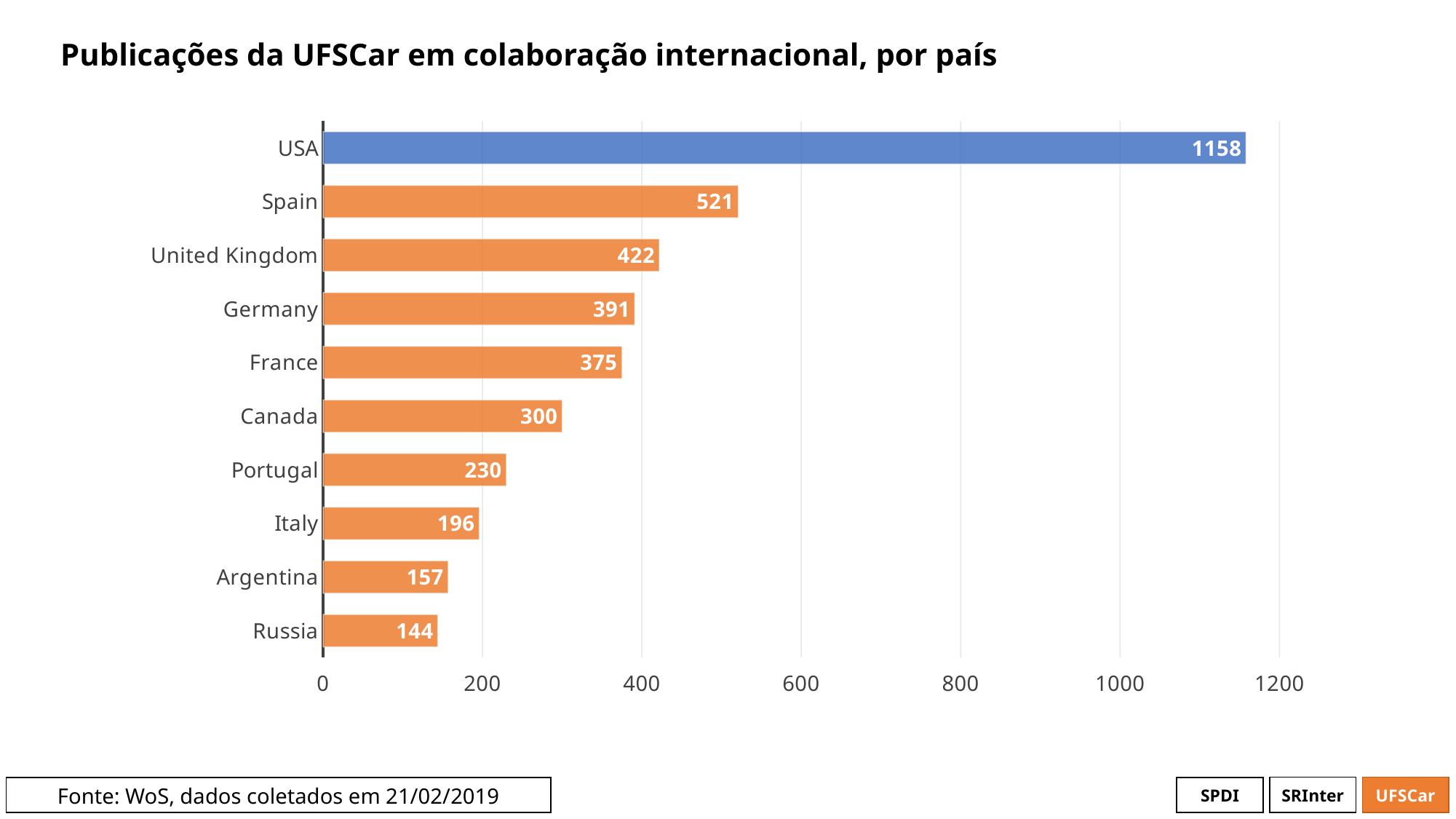
Which has a larger value, United Kingdom or France? United Kingdom What is the value shown for Germany? 391 How many countries are shown in the chart? 10 Which country has the highest number of publications? USA What is the difference between the values for USA and Spain? 637 Is the value for Canada greater or less than 400? less How many publications in international collaboration does the chart show for Spain? 521 What is the difference between the values for Italy and Argentina? 39 Which country has the lowest number of publications? Russia What kind of chart is shown on the slide? Bar chart What is the value shown for Portugal? 230 Which country's bar is coloured blue rather than orange? USA